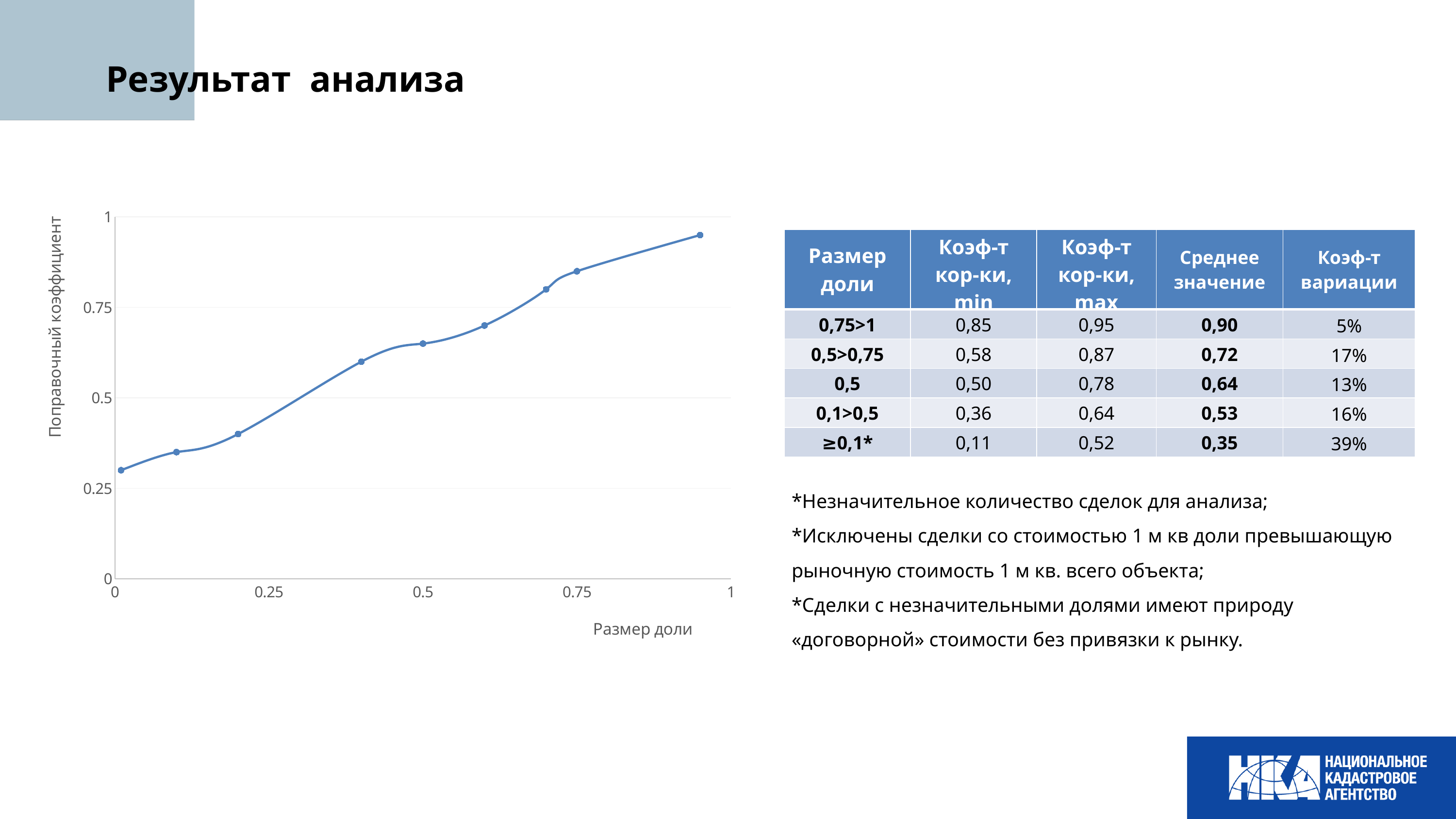
What is the title of the x axis of the chart? Размер доли Is the value of the point at Размер доли 0.75 greater or less than 0.75? greater Is the value of the point at Размер доли 0.5 greater or less than 0.75? less Is the value of the rightmost point on the chart greater or less than 1? less Which point has the higher value: the one at Размер доли 0.5 or the one at Размер доли 0.75? the one at 0.75 What kind of chart is shown on the slide? line chart What is the title of the y axis of the chart? Поправочный коэффициент Does the correction coefficient (Поправочный коэффициент) rise or fall as the share size (Размер доли) increases along the x axis? rise How many data points are plotted on the line chart? 9